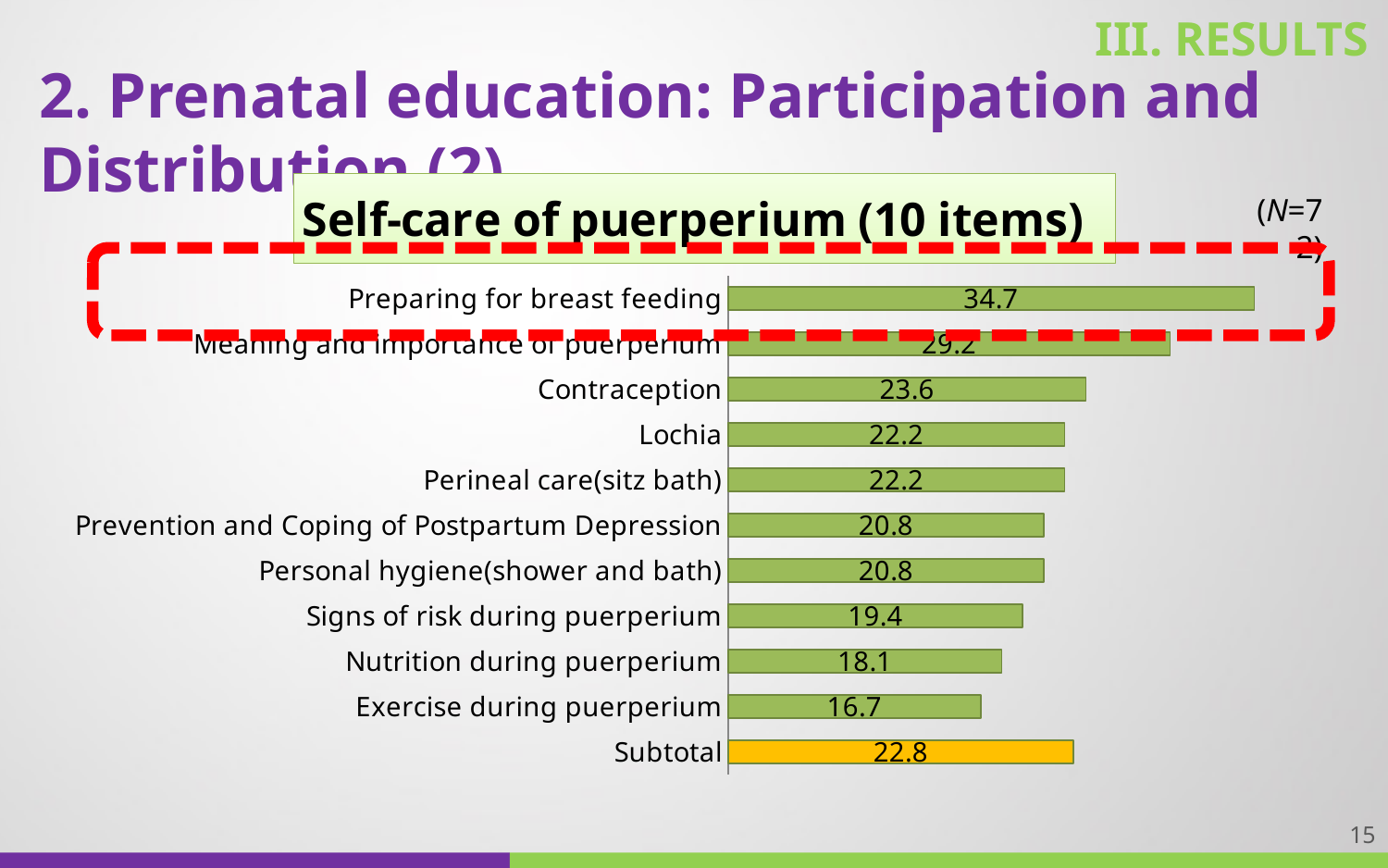
What is the title of the chart? Self-care of puerperium (10 items) What is the value shown for Subtotal? 22.8 Which item has the lowest value? Exercise during puerperium What type of chart is shown? Bar chart What is the value for Exercise during puerperium? 16.7 What is the value for Contraception? 23.6 Which is larger, Signs of risk during puerperium or Nutrition during puerperium? Signs of risk during puerperium How many bars are plotted in the chart, including Subtotal? 11 Which item has the highest value? Preparing for breast feeding What is the value for Preparing for breast feeding? 34.7 What is the difference between Contraception and Nutrition during puerperium? 5.5 What is the difference between Preparing for breast feeding and Meaning and importance of puerperium? 5.5